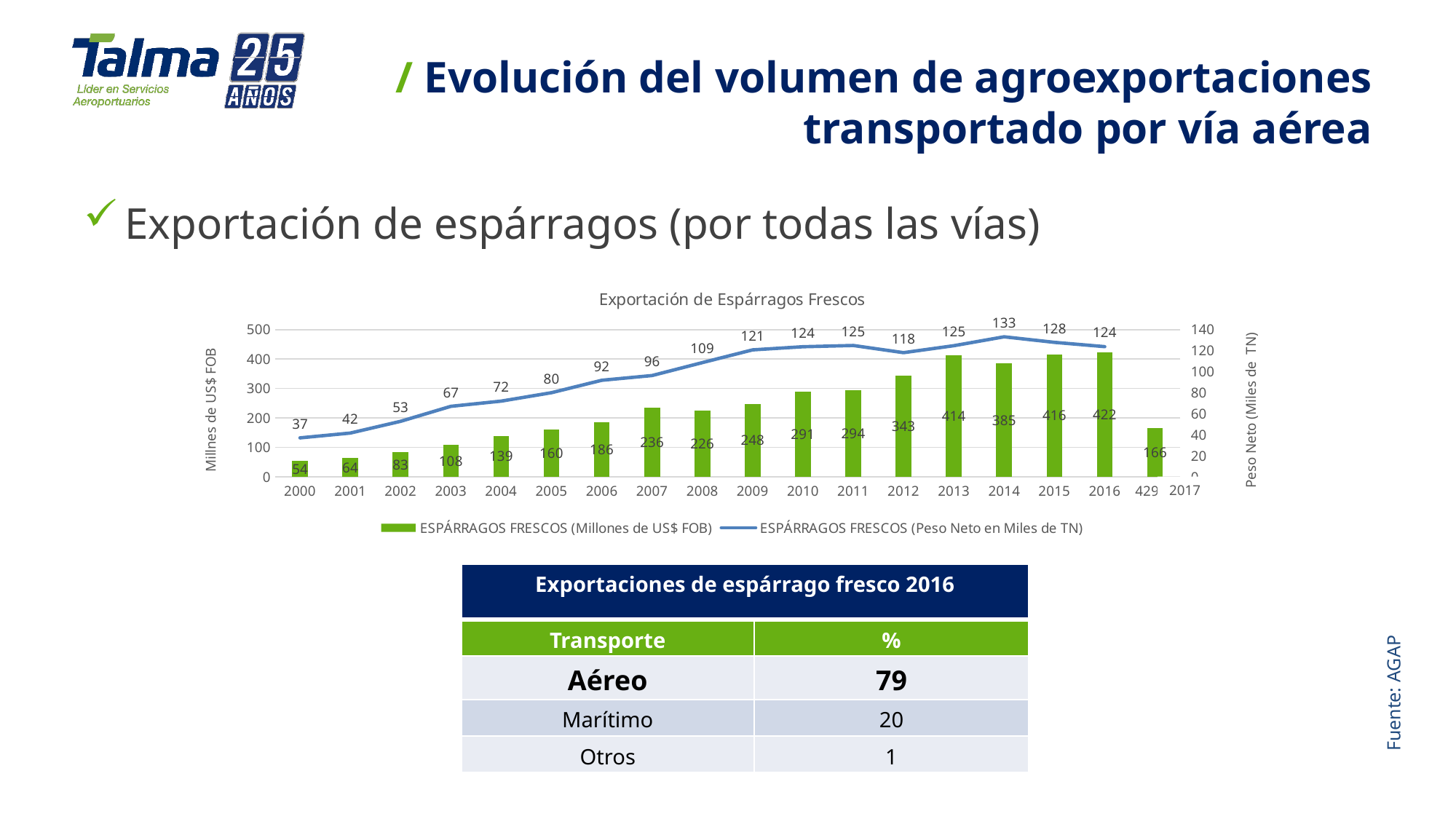
In the chart 'Exportación de Espárragos Frescos', which year has the highest value on the Peso Neto (Miles de TN) line? 2014 In the chart 'Exportación de Espárragos Frescos', what is the bar value for 2008? 226 In the chart 'Exportación de Espárragos Frescos', which year has the lowest bar value (Millones de US$ FOB)? 2000 In the chart 'Exportación de Espárragos Frescos', what is the difference between the bar values for 2016 and 2015? 6 What kind of chart is 'Exportación de Espárragos Frescos'? Combined bar and line chart In the chart 'Exportación de Espárragos Frescos', what is the value of the line (Peso Neto en Miles de TN) for 2014? 133 In the chart 'Exportación de Espárragos Frescos', which year has the larger bar value, 2013 or 2014? 2013 In the chart 'Exportación de Espárragos Frescos', what is the value of the bar (Millones de US$ FOB) for 2016? 422 In the chart 'Exportación de Espárragos Frescos', is the bar value for 2012 greater or less than 300? greater In the chart 'Exportación de Espárragos Frescos', does the Peso Neto line rise or fall from 2000 to 2011? Rise How many series does the legend of the chart 'Exportación de Espárragos Frescos' list? 2 In the chart 'Exportación de Espárragos Frescos', what colour are the bars? Green